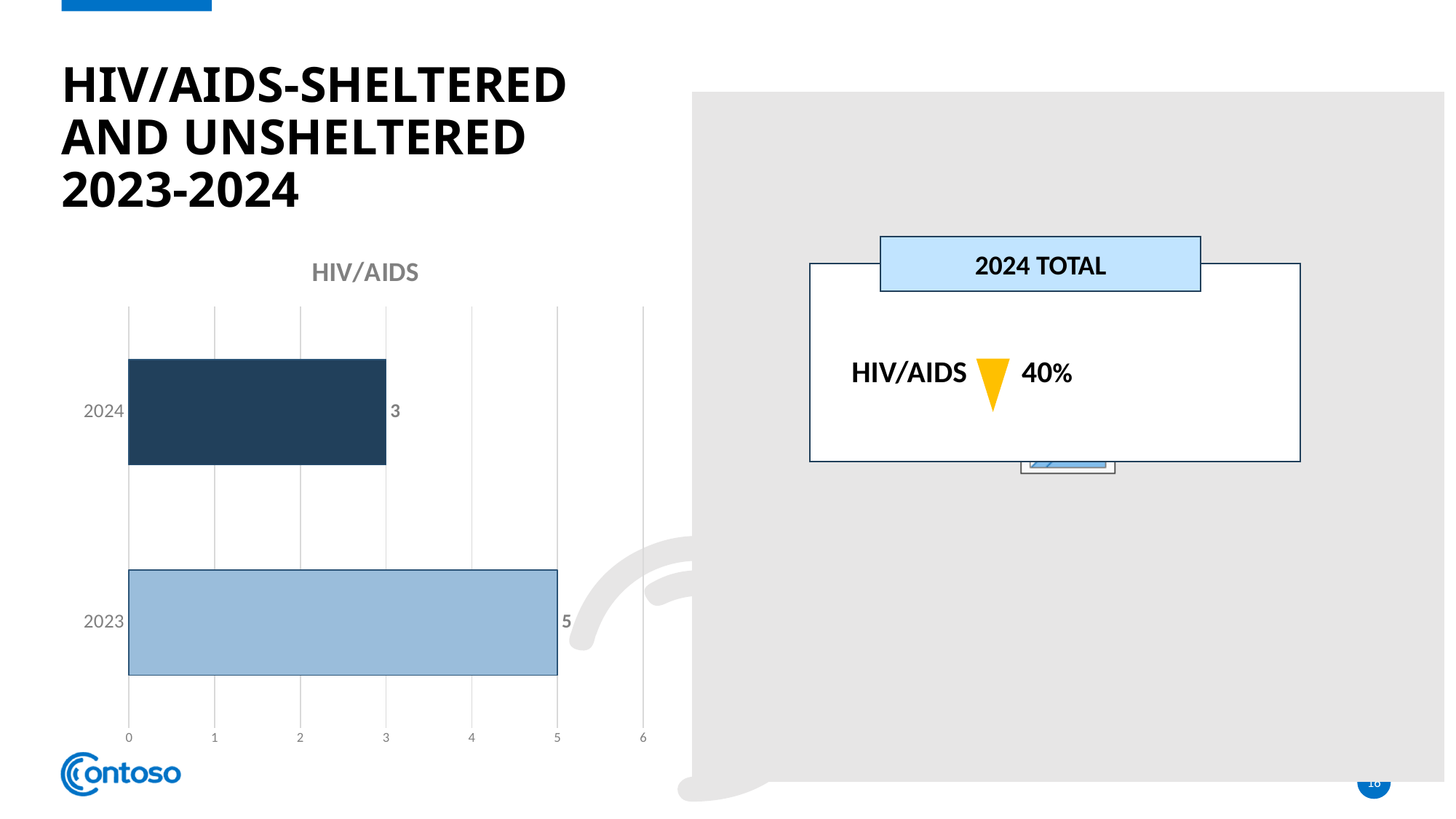
Did the HIV/AIDS value rise or fall from 2023 to 2024? fall Which year has the higher value in the HIV/AIDS chart? 2023 Which year has the lower value in the HIV/AIDS chart? 2024 What is the title of the chart on the slide? HIV/AIDS What is the highest value shown on the horizontal axis of the HIV/AIDS chart? 6 What kind of chart is the HIV/AIDS chart? bar chart What is the value for 2023 in the HIV/AIDS chart? 5 Is the value for 2024 in the HIV/AIDS chart greater or less than 4? less What is the value for 2024 in the HIV/AIDS chart? 3 Is the value for 2023 larger or smaller than the value for 2024 in the HIV/AIDS chart? larger How many years are shown in the HIV/AIDS chart? 2 What is the difference between the 2023 and 2024 values in the HIV/AIDS chart? 2